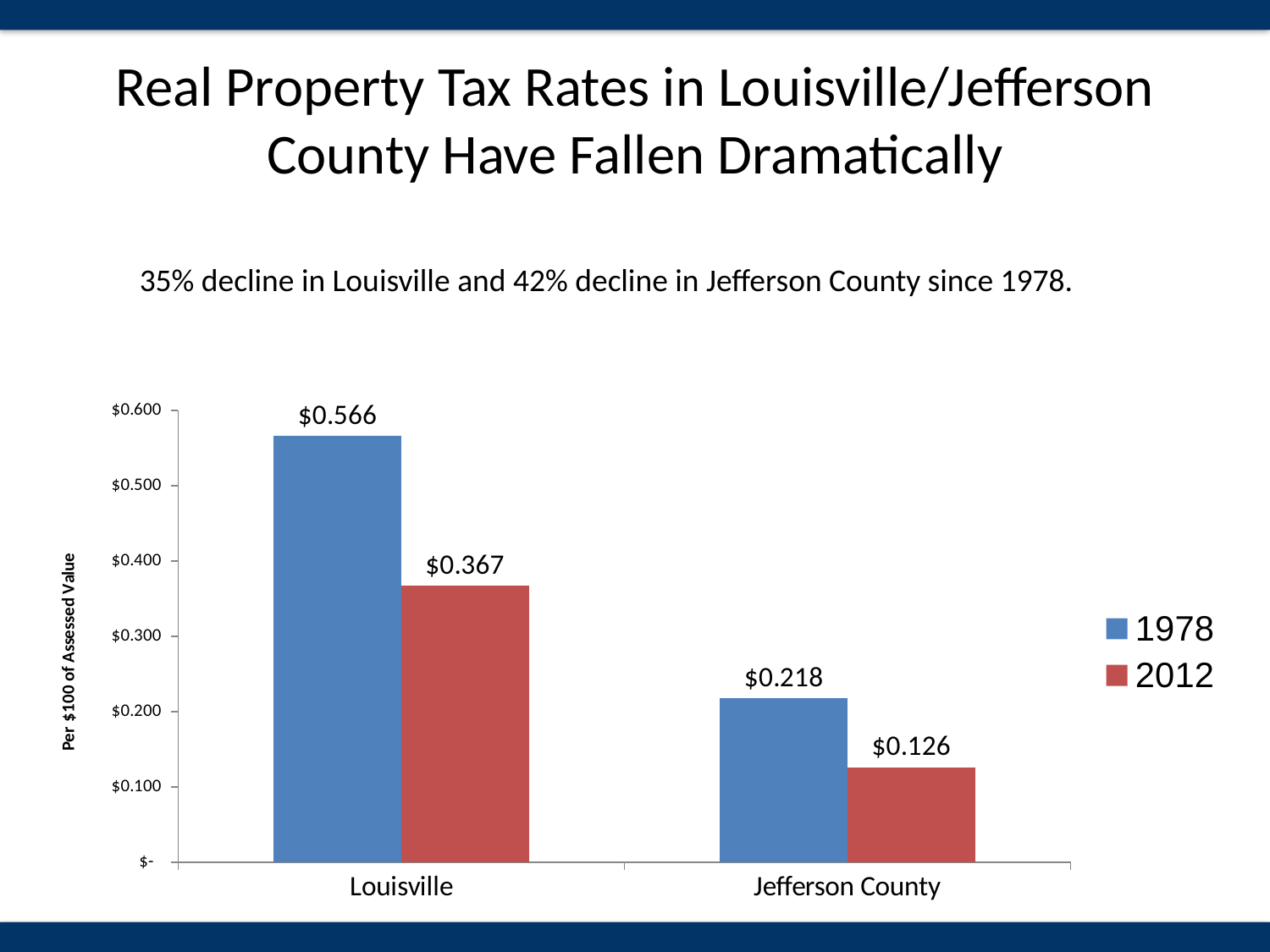
By how much did the Jefferson County tax rate fall between 1978 and 2012? $0.092 What was the real property tax rate in Louisville in 2012? $0.367 Which bar in the chart has the lowest value? Jefferson County, 2012 What is the label on the vertical axis of the chart? Per $100 of Assessed Value What was the real property tax rate in Jefferson County in 2012? $0.126 By how much did the Louisville tax rate fall between 1978 and 2012? $0.199 What kind of chart is shown on the slide? Bar chart What was the real property tax rate in Louisville in 1978? $0.566 What was the real property tax rate in Jefferson County in 1978? $0.218 Which was larger, the 2012 rate in Louisville or the 1978 rate in Jefferson County? 2012 rate in Louisville How many series does the legend list? 2 Which bar in the chart has the highest value? Louisville, 1978